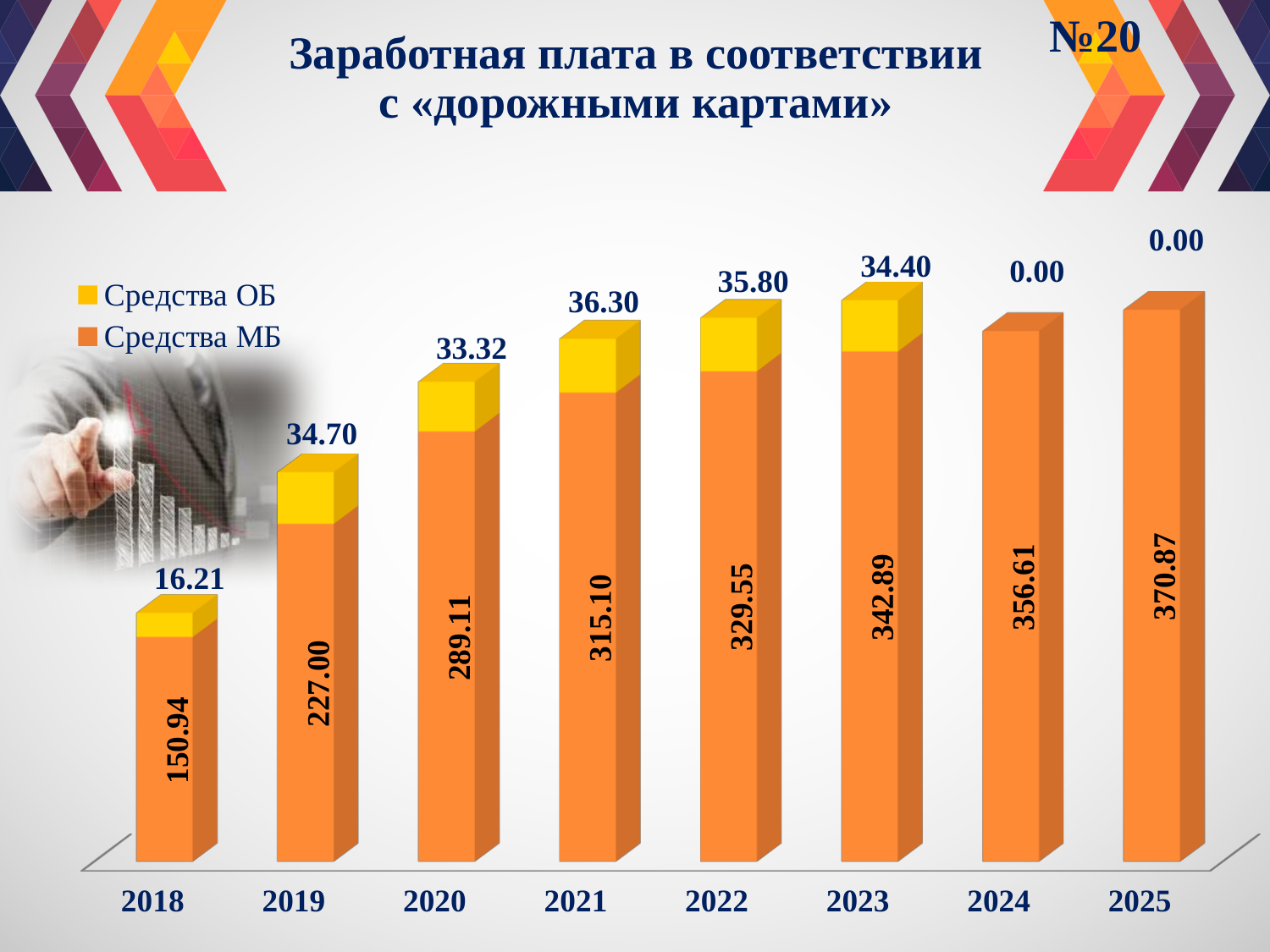
How many series does the legend list? 2 In which year is Средства МБ the lowest? 2018 What is the difference between Средства МБ in 2025 and in 2018? 219.93 In which year is Средства МБ the highest? 2025 Which is larger: Средства ОБ in 2019 or in 2023? 2019 Does Средства МБ rise or fall from 2018 to 2025? Rise What is the value of Средства ОБ for 2024? 0.00 What is the value of Средства ОБ for 2021? 36.30 What is the total of the stacked bar for 2018? 167.15 What is the value of Средства МБ for 2020? 289.11 What type of chart is shown on the slide? Stacked bar chart How many years are shown on the x axis? 8